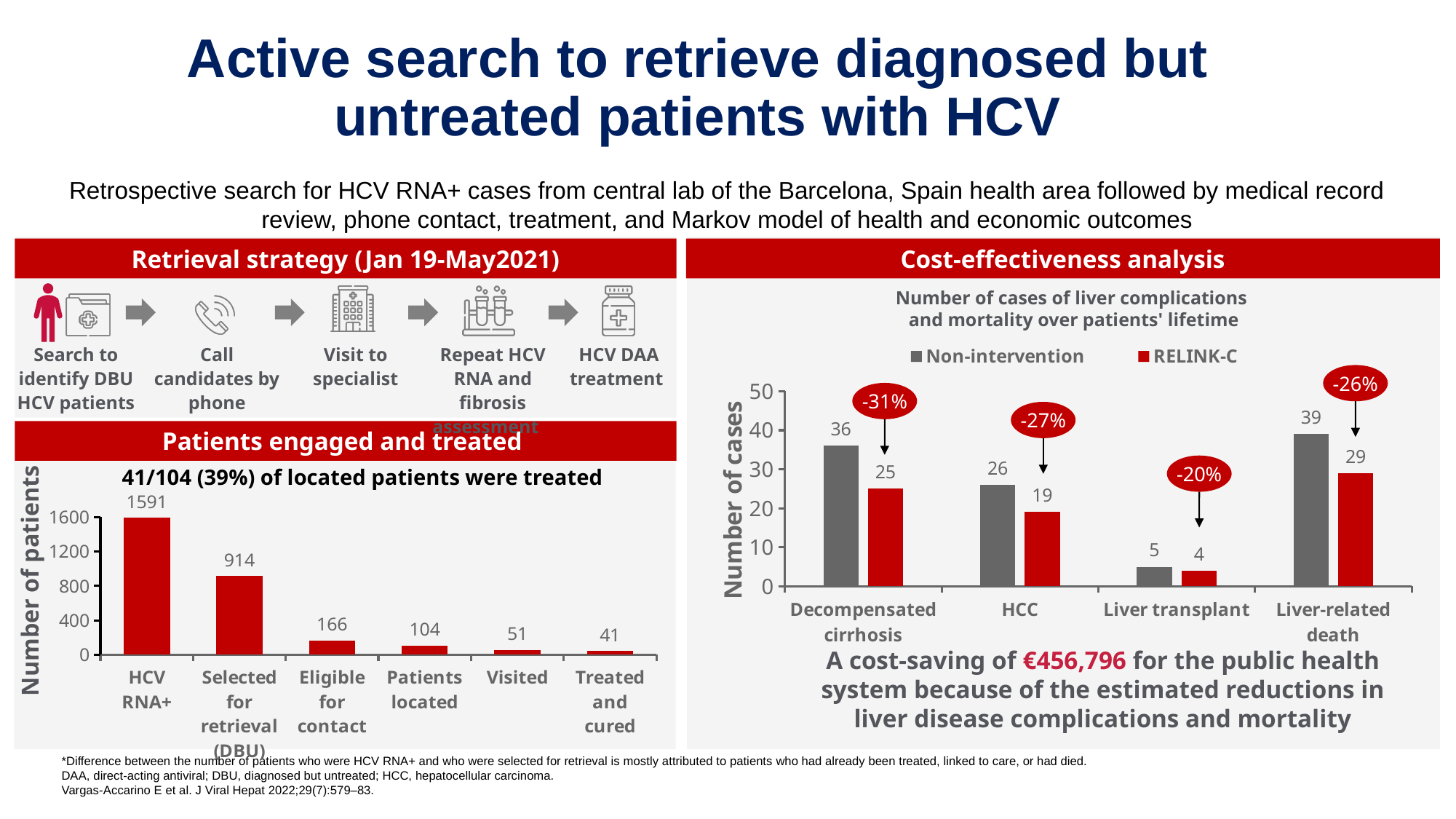
In the 'Patients engaged and treated' chart, how many categories are shown on the x axis? 6 In the 'Cost-effectiveness analysis' chart, what is the Non-intervention value for Liver-related death? 39 In the 'Patients engaged and treated' chart, do the values rise or fall from left to right along the x axis? fall In the 'Cost-effectiveness analysis' chart, how many series does the legend list? 2 In the 'Patients engaged and treated' chart, what is the difference between the number of patients located and the number visited? 53 In the 'Cost-effectiveness analysis' chart, what is the difference between Non-intervention and RELINK-C for Decompensated cirrhosis? 11 In the 'Patients engaged and treated' chart, which category has the lowest number of patients? Treated and cured What kind of chart is the 'Cost-effectiveness analysis' chart? bar chart In the 'Patients engaged and treated' chart, how many patients were HCV RNA+? 1591 In the 'Patients engaged and treated' chart, how many patients were selected for retrieval (DBU)? 914 In the 'Cost-effectiveness analysis' chart, which is larger for Liver transplant: Non-intervention or RELINK-C? Non-intervention In the 'Cost-effectiveness analysis' chart, what is the RELINK-C value for HCC? 19